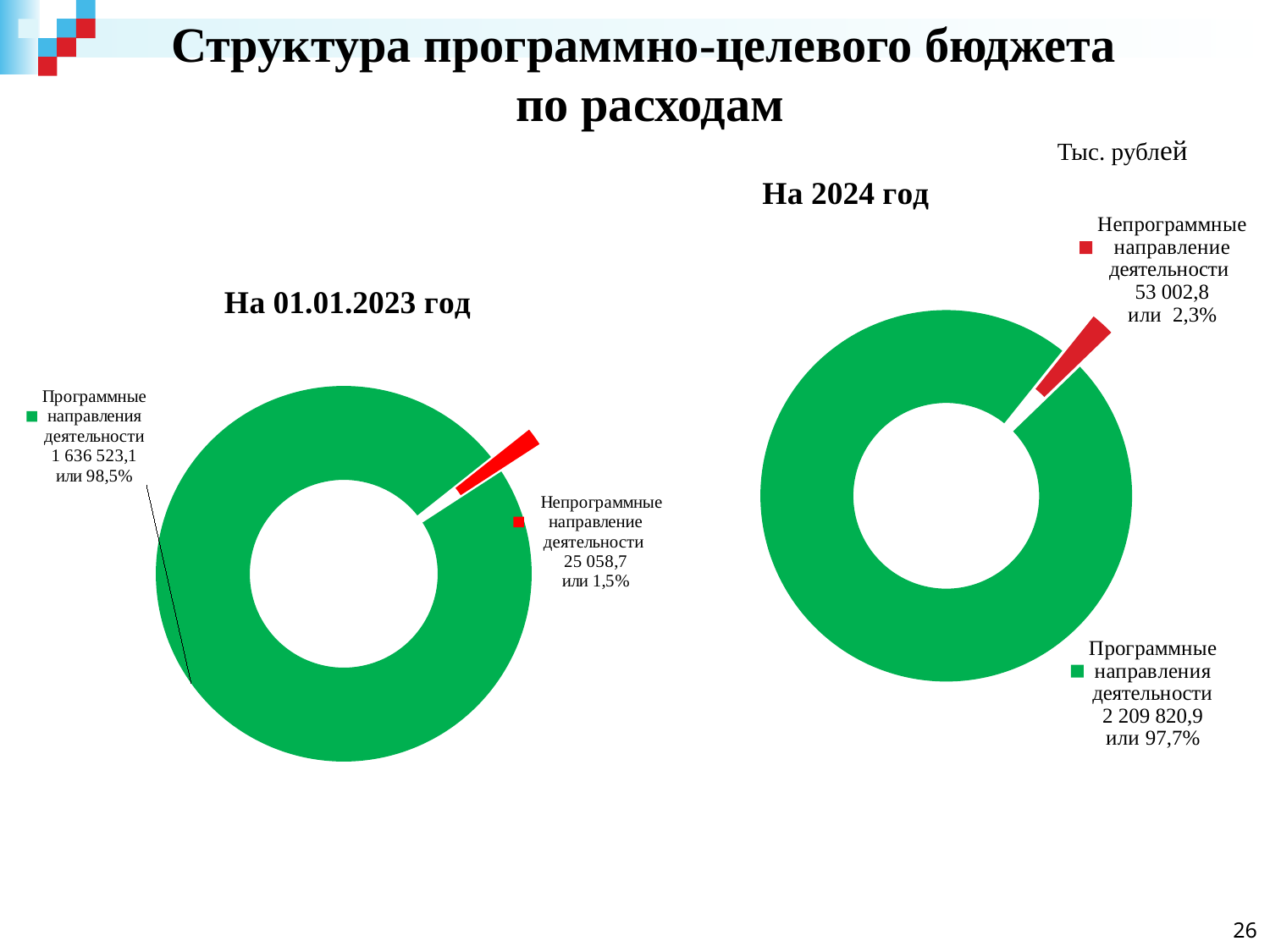
In the chart 'На 01.01.2023 год', which category is the smallest? Непрограммные направление деятельности What type of chart is used on the slide for 'На 01.01.2023 год'? Doughnut (pie) chart In the chart 'На 2024 год', which category is the largest? Программные направления деятельности In the chart 'На 2024 год', what is the value for 'Непрограммные направление деятельности'? 53 002,8 In the chart 'На 2024 год', what share of the total does 'Непрограммные направление деятельности' represent? 2,3% In the chart 'На 2024 год', what is the value for 'Программные направления деятельности'? 2 209 820,9 What colour represents 'Непрограммные направление деятельности' in the chart 'На 2024 год'? Red In the chart 'На 01.01.2023 год', what is the value for 'Непрограммные направление деятельности'? 25 058,7 In the chart 'На 01.01.2023 год', what share of the total does 'Программные направления деятельности' represent? 98,5% How many categories does the chart 'На 2024 год' show? 2 In the chart 'На 01.01.2023 год', what is the value for 'Программные направления деятельности'? 1 636 523,1 Which is larger: 'Непрограммные направление деятельности' in the chart 'На 01.01.2023 год' or in the chart 'На 2024 год'? На 2024 год